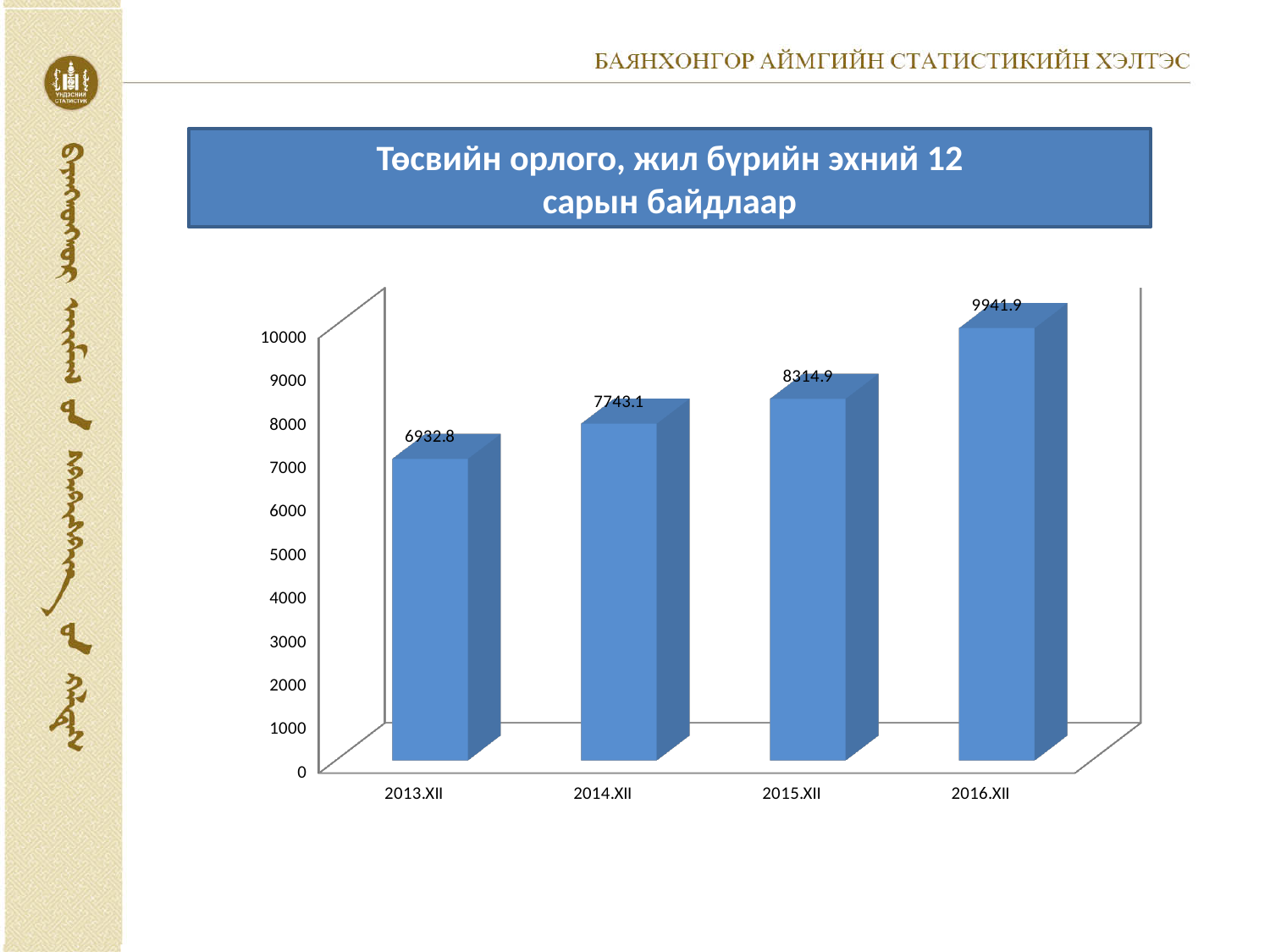
Which category has the lowest value? 2013.XII What is the difference between the values for 2016.XII and 2015.XII? 1627.0 What is the difference between the values for 2014.XII and 2013.XII? 810.3 Which category has the highest value? 2016.XII What kind of chart is shown on the slide? bar chart Do the values rise or fall from 2013.XII to 2016.XII? rise How many categories are shown on the x axis? 4 What is the value for 2015.XII? 8314.9 Which is larger, the value for 2014.XII or the value for 2015.XII? 2015.XII What is the value for 2013.XII? 6932.8 What is the value for 2014.XII? 7743.1 What is the value for 2016.XII? 9941.9